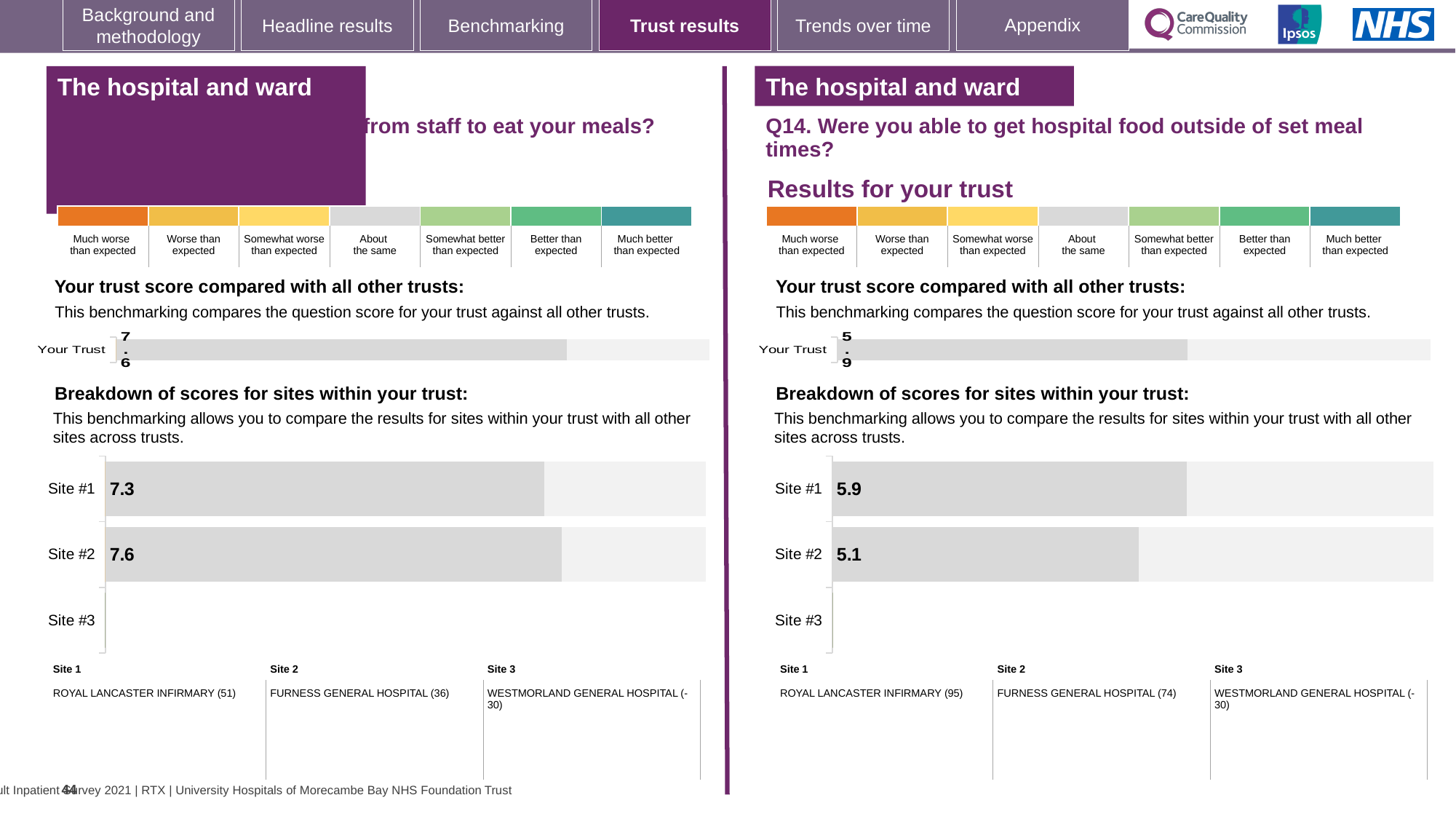
On the right-hand chart for Q14, what is the score for Site #2? 5.1 On the right-hand chart for Q14 (hospital food outside of set meal times), what is the score for Site #1? 5.9 On the left-hand chart (question about help from staff to eat your meals), which site has the higher score, Site #1 or Site #2? Site #2 On the left-hand chart (question about help from staff to eat your meals), what is the 'Your Trust' score? 7.6 On the right-hand chart for Q14, which site has the higher score, Site #1 or Site #2? Site #1 On the left-hand chart (question about help from staff to eat your meals), what is the difference between the Site #2 and Site #1 scores? 0.3 On the right-hand chart for Q14, what is the 'Your Trust' score? 5.9 How many site categories are listed on the right-hand site breakdown chart for Q14? 3 What type of chart is used to show the breakdown of scores for sites within the trust on the right-hand side? Bar chart On the left-hand chart (question about help from staff to eat your meals), what is the score for Site #1? 7.3 On the left-hand chart (question about help from staff to eat your meals), what is the score for Site #2? 7.6 On the right-hand chart for Q14, what is the difference between the Site #1 and Site #2 scores? 0.8